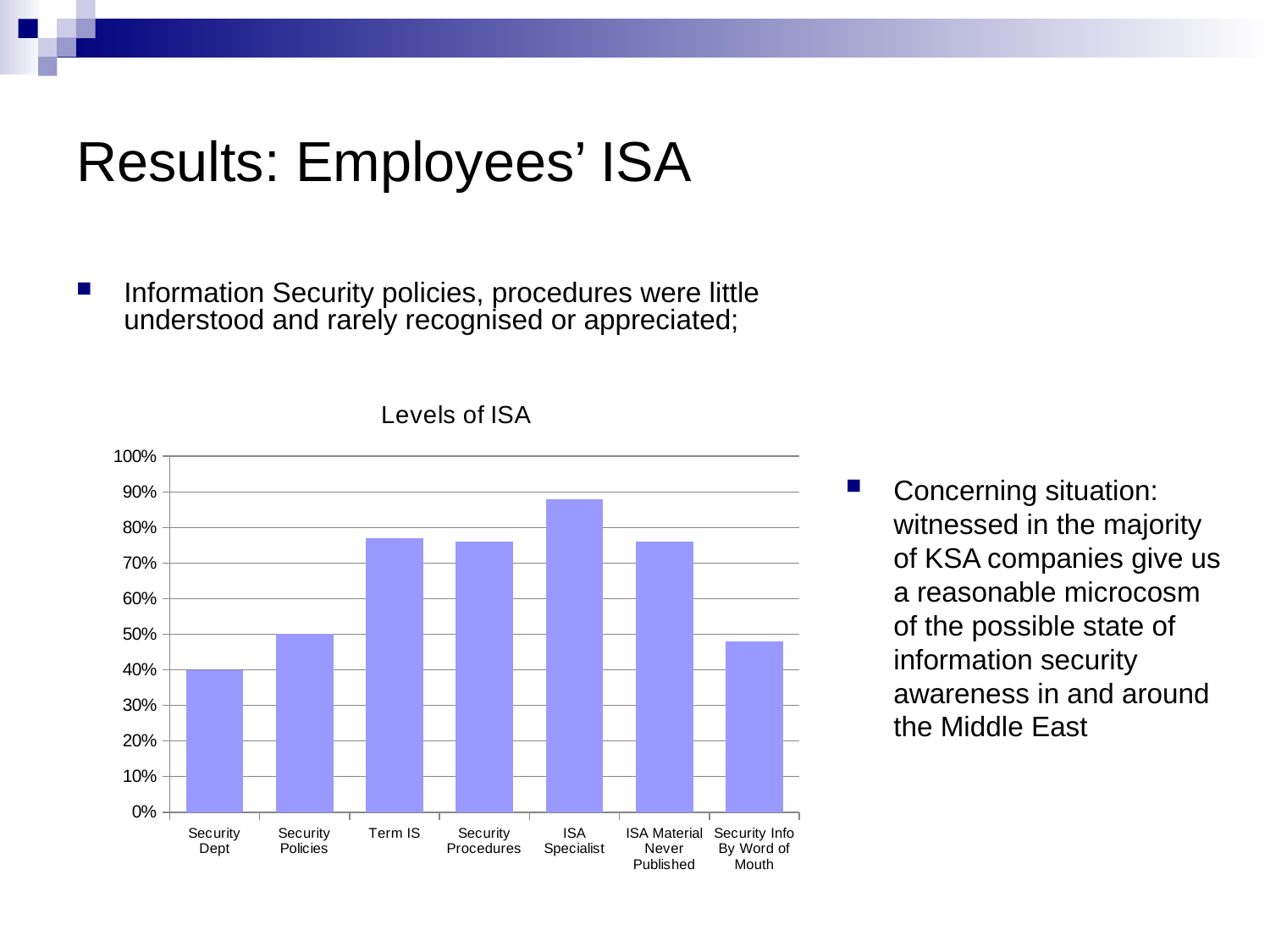
Is the value for Security Info By Word of Mouth greater or less than 50%? less What is the value for Security Dept? 40% Which is larger, the value for ISA Specialist or the value for Security Procedures? ISA Specialist How many categories are shown on the x axis of the chart? 7 Which category has the lowest value? Security Dept Which category has the highest value? ISA Specialist What is the difference between the values for Security Policies and Security Dept? 10% What is the value for Security Policies? 50% Is the value for ISA Specialist greater or less than 80%? greater What is the title of the chart? Levels of ISA What type of chart is shown on the slide? bar chart Is the value for Term IS greater or less than 70%? greater